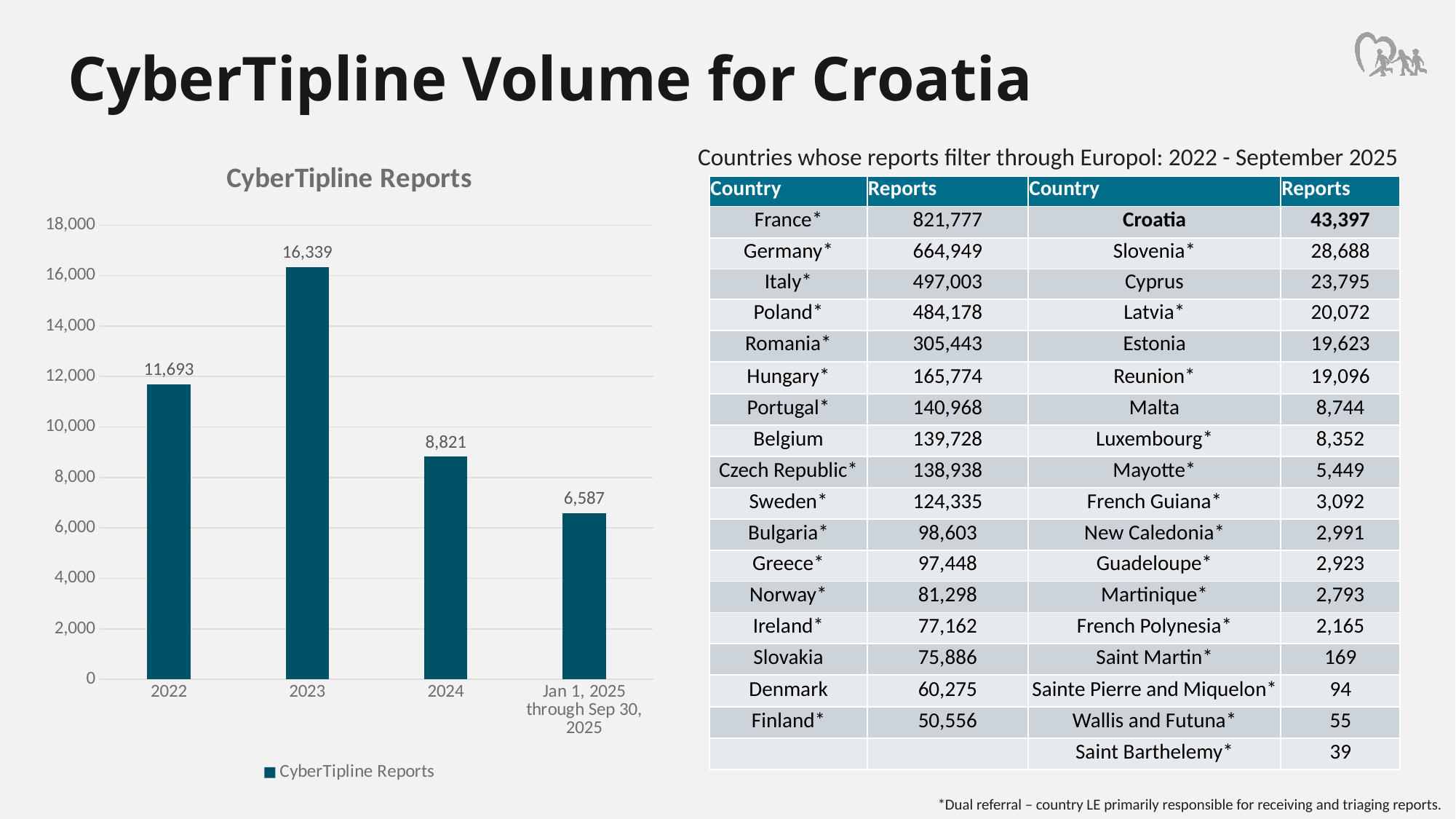
What is the value of CyberTipline Reports for 2024? 8,821 Which period has the lowest number of CyberTipline Reports? Jan 1, 2025 through Sep 30, 2025 How many periods are shown on the x axis of the CyberTipline Reports chart? 4 What kind of chart is the CyberTipline Reports chart? bar chart What is the value of CyberTipline Reports for Jan 1, 2025 through Sep 30, 2025? 6,587 What is the difference in CyberTipline Reports between 2024 and Jan 1, 2025 through Sep 30, 2025? 2,234 Which period has the highest number of CyberTipline Reports? 2023 What is the value of CyberTipline Reports for 2022? 11,693 What is the difference in CyberTipline Reports between 2023 and 2022? 4,646 How many series does the legend of the CyberTipline Reports chart list? 1 What is the value of CyberTipline Reports for 2023? 16,339 Which has more CyberTipline Reports, 2022 or 2024? 2022